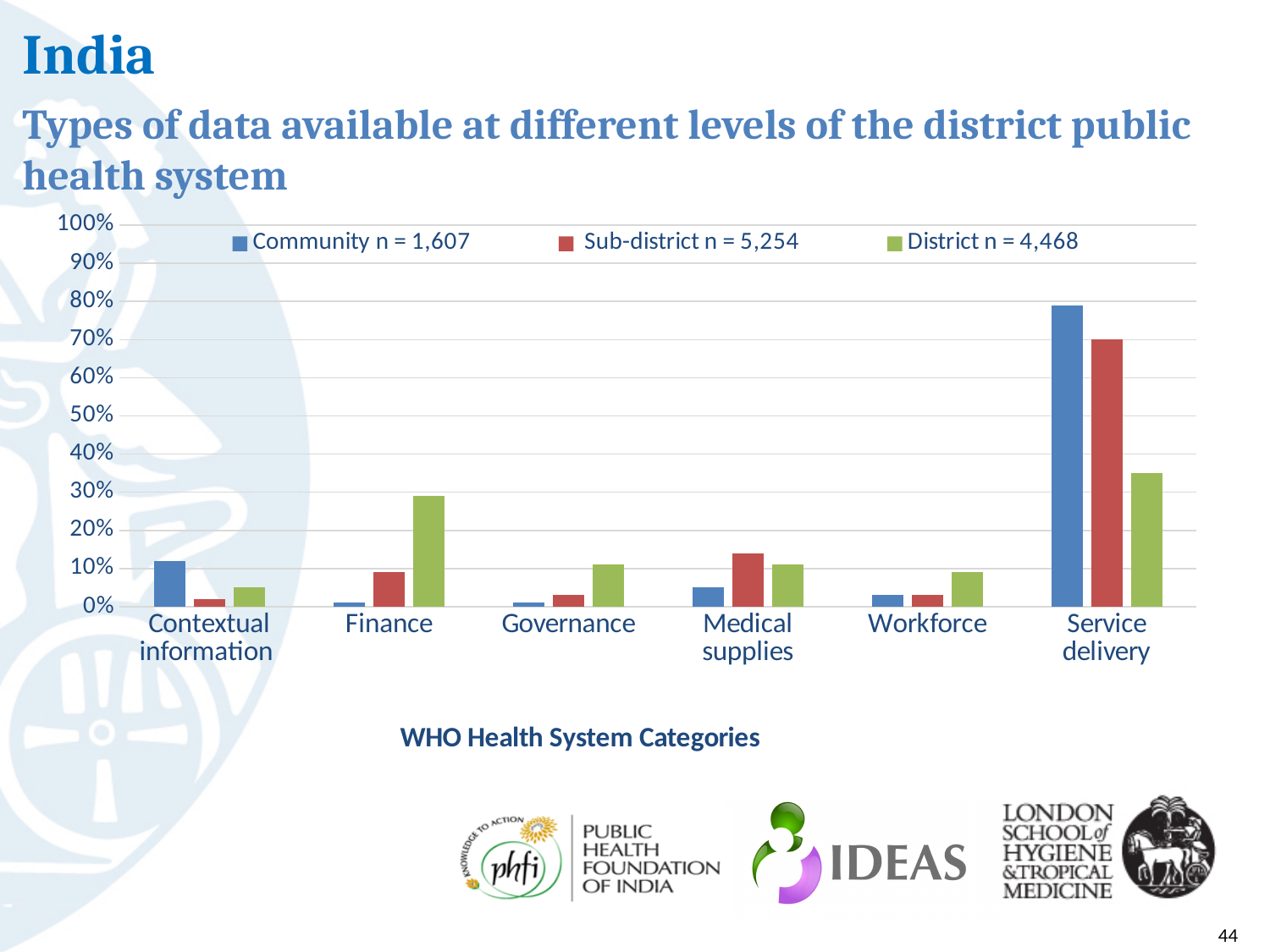
Is the Community value for Service delivery greater or less than 70%? greater Which category has the highest value for the Community series? Service delivery Is the District value for Service delivery greater or less than 40%? less How many series does the legend list? 3 Is the District value for Finance greater or less than 20%? greater How many WHO Health System Categories are shown on the x axis? 6 What is the x-axis title of the chart? WHO Health System Categories For Finance, which series has the highest value? District What type of chart is shown on the slide? bar chart What is the sample size (n) given in the legend for the Sub-district series? 5,254 For Service delivery, which is larger: the Community value or the Sub-district value? Community